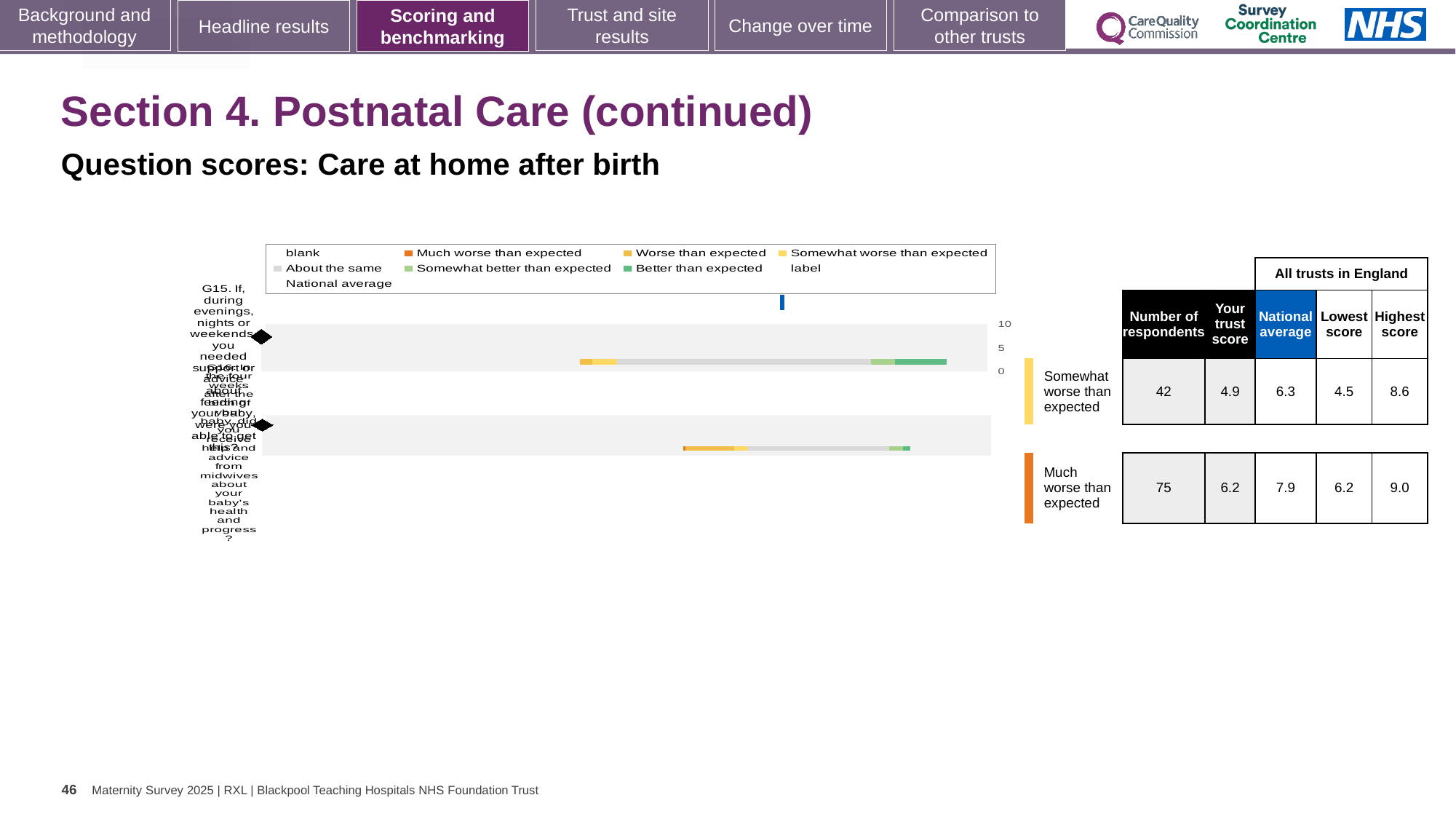
In the table, how many respondents are listed for the question rated 'Somewhat worse than expected'? 42 Which question has the higher trust score: the one rated 'Somewhat worse than expected' or the one rated 'Much worse than expected'? Much worse than expected In the table, what is the lowest score for the question rated 'Somewhat worse than expected'? 4.5 What is the difference between the highest and lowest scores for the question rated 'Much worse than expected'? 2.8 How many question bars are plotted in the chart? 2 In the table, what is the highest score for the question rated 'Much worse than expected'? 9.0 By how much does the national average exceed the trust score for the question rated 'Somewhat worse than expected'? 1.4 In the table, what is the national average for the question rated 'Somewhat worse than expected'? 6.3 In the table, what is the trust score for the question rated 'Much worse than expected'? 6.2 What kind of chart is shown on the slide? bar chart What is the subtitle of the chart on the slide? Question scores: Care at home after birth What colour represents 'Much worse than expected' in the chart legend? orange